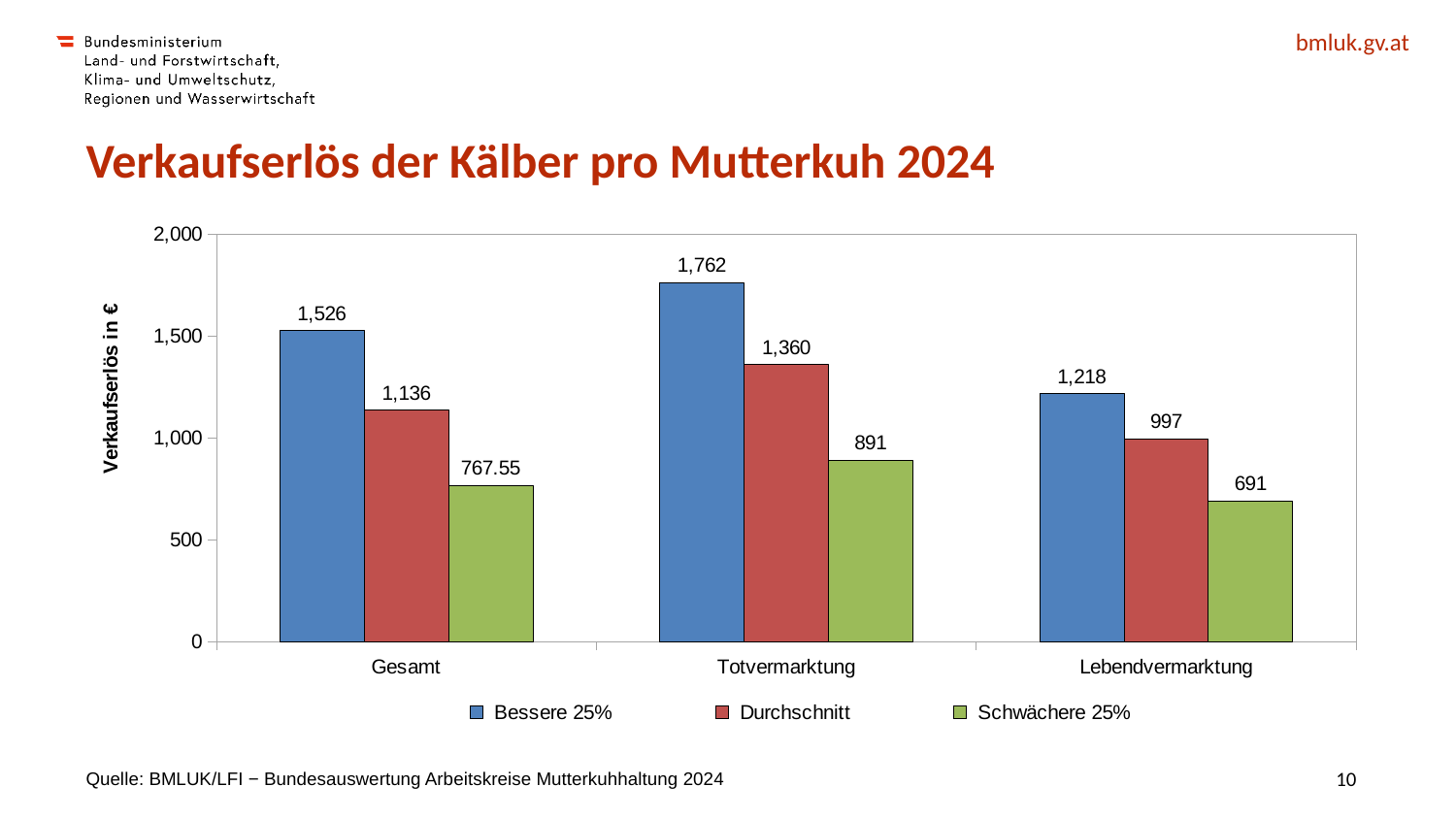
What is the value for Schwächere 25% in the Gesamt category? 767.55 What is the value for Bessere 25% in the Totvermarktung category? 1,762 Which category has the highest value for Bessere 25%? Totvermarktung Which category has the lowest value for Schwächere 25%? Lebendvermarktung What is the value for Durchschnitt in the Lebendvermarktung category? 997 What is the difference between the Bessere 25% and Durchschnitt values in the Gesamt category? 390 What is the title of the chart? Verkaufserlös der Kälber pro Mutterkuh 2024 What kind of chart is shown on the slide? Bar chart What is the label of the y axis? Verkaufserlös in € How many categories are shown on the x axis? 3 How many series does the legend list? 3 Which is larger: the Durchschnitt value for Totvermarktung or the Bessere 25% value for Lebendvermarktung? Durchschnitt value for Totvermarktung